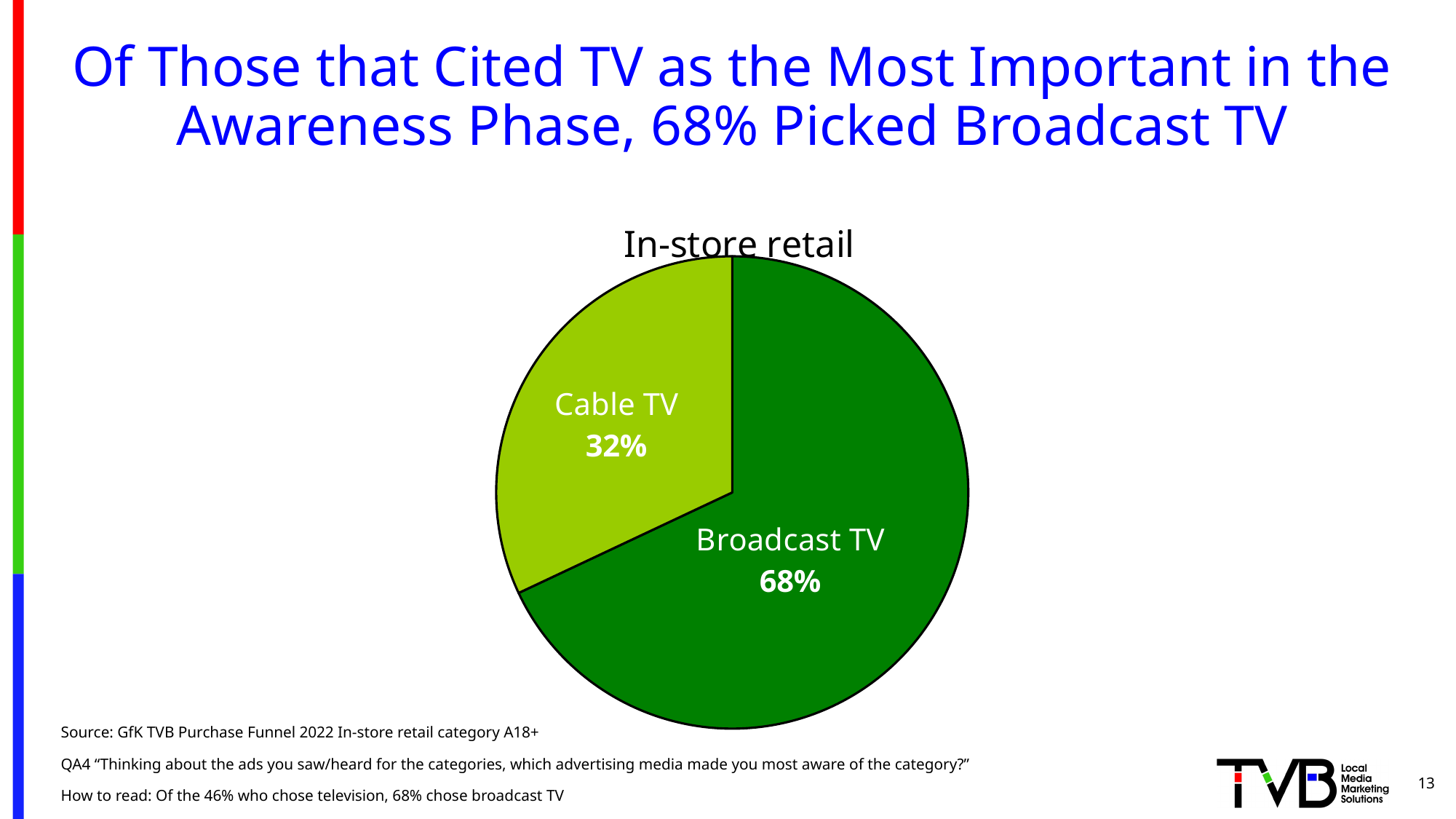
Which slice of the pie is the smallest? Cable TV Which slice is shown in the lighter green colour? Cable TV Is the Cable TV share greater or less than 50%? less Which is larger, the Cable TV slice or the Broadcast TV slice? Broadcast TV What is the title of the chart? In-store retail What do the two slices of the pie add up to? 100% What kind of chart is shown on the slide? Pie chart What share of the pie does Broadcast TV hold? 68% What share of the pie does Cable TV hold? 32% How many slices does the pie chart have? 2 What is the difference in percentage points between the Broadcast TV and Cable TV slices? 36 Which slice of the pie is the largest? Broadcast TV